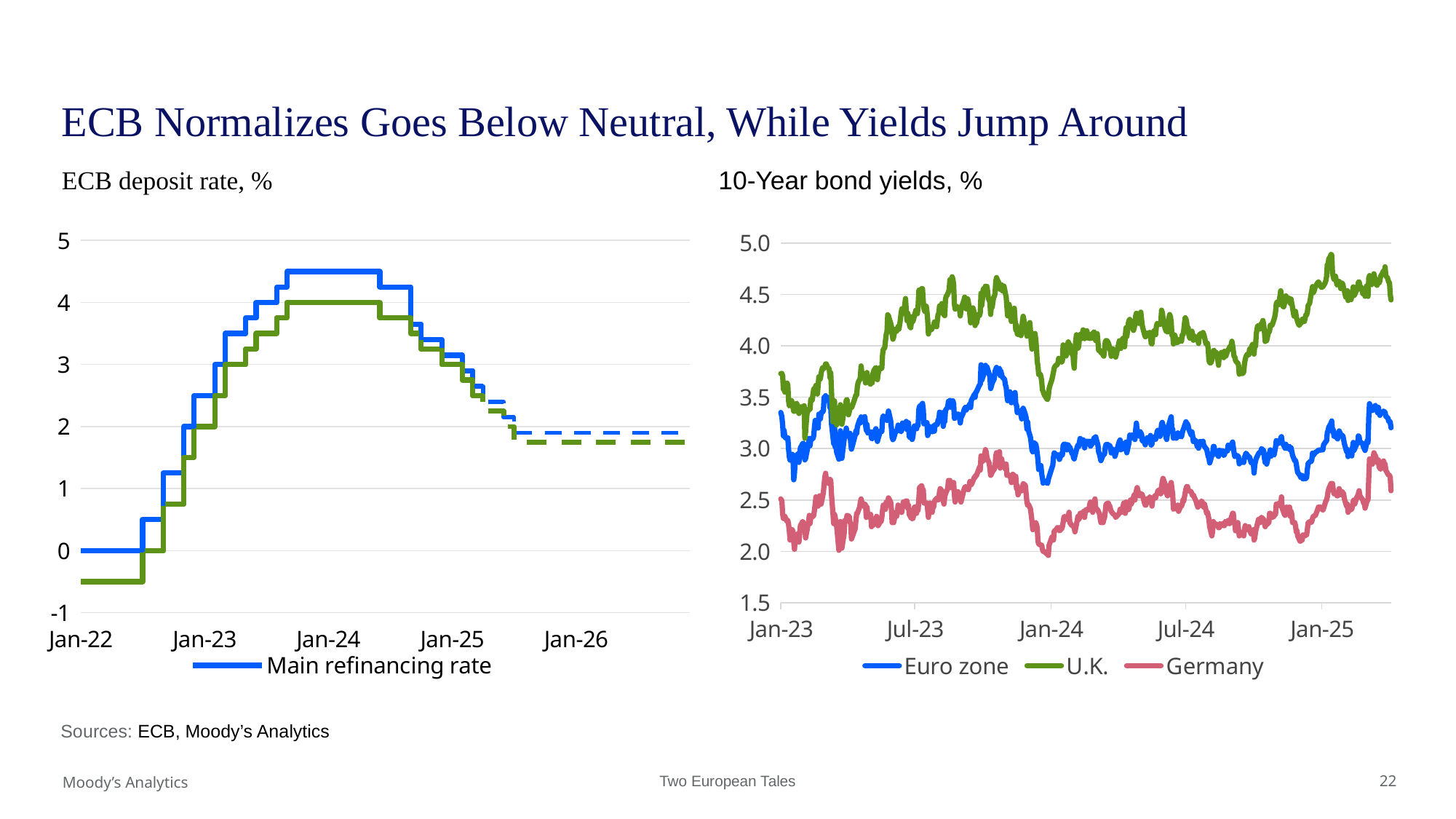
In the '10-Year bond yields, %' chart, which series are listed in the legend? Euro zone, U.K., Germany In the '10-Year bond yields, %' chart, is the Euro zone value at Jan-25 greater or less than 3.5? less In the '10-Year bond yields, %' chart, which series has the lowest values across the period shown? Germany In the 'ECB deposit rate, %' chart, does the Main refinancing rate rise or fall between Jan-24 and Jan-26? fall What kind of chart is the right chart titled '10-Year bond yields, %'? line chart In the '10-Year bond yields, %' chart, at Jan-24, which is larger: the U.K. yield or the Germany yield? U.K. In the '10-Year bond yields, %' chart, how many series does the legend list? 3 In the 'ECB deposit rate, %' chart, is the peak value of the Main refinancing rate greater or less than 4? greater In the '10-Year bond yields, %' chart, which series has the highest values across the period shown? U.K. What kind of chart is the left chart titled 'ECB deposit rate, %'? line chart In the '10-Year bond yields, %' chart, is the highest value reached by the U.K. series greater or less than 4.5? greater In the 'ECB deposit rate, %' chart, does the Main refinancing rate rise or fall between Jan-22 and Jan-24? rise